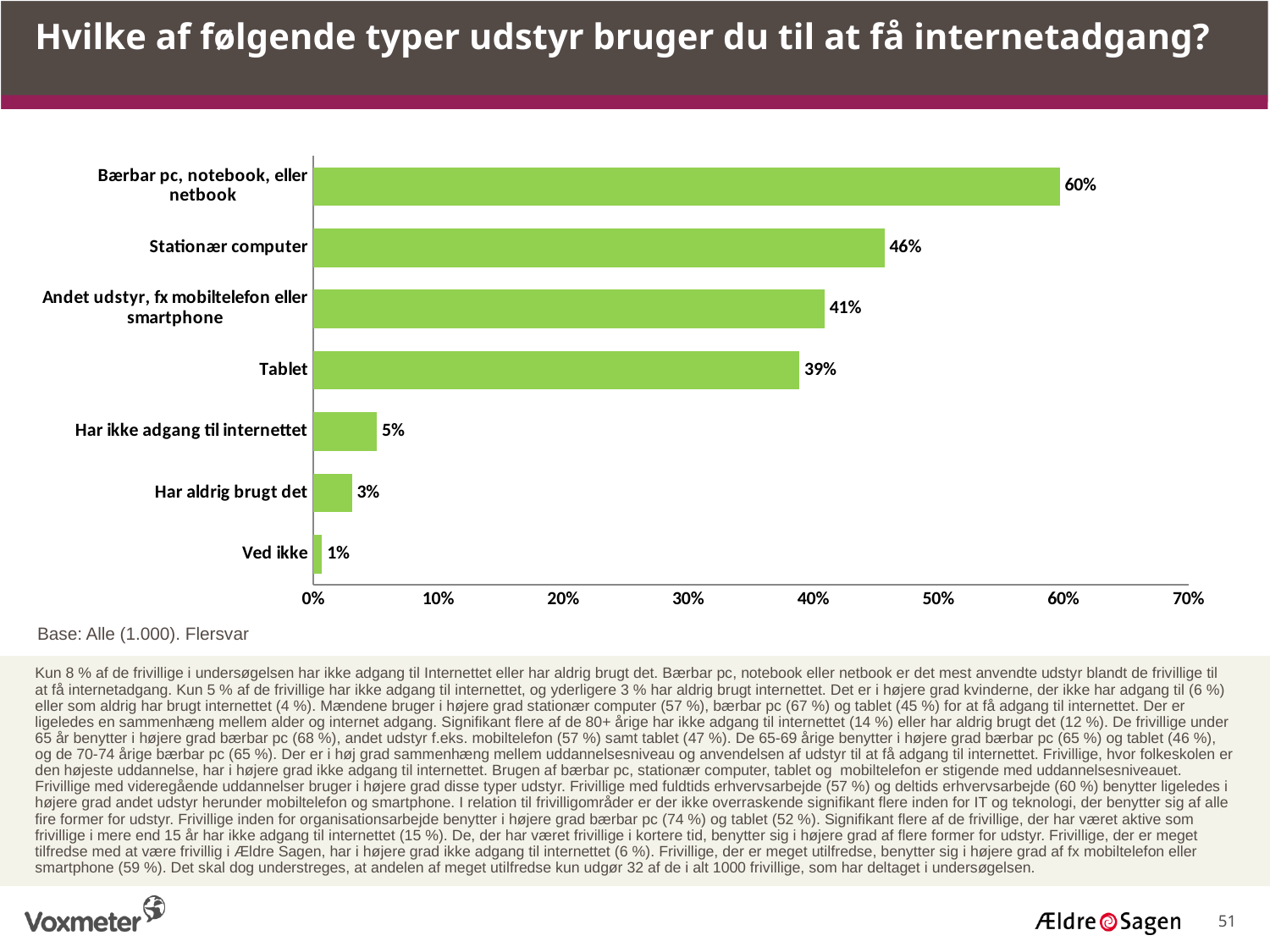
Which is larger, the value for "Har aldrig brugt det" or the value for "Har ikke adgang til internettet"? Har ikke adgang til internettet What is the value for "Stationær computer"? 46% What is the value for "Har ikke adgang til internettet"? 5% What is the difference between the values for "Bærbar pc, notebook, eller netbook" and "Stationær computer"? 14% What kind of chart is shown on the slide? bar chart What is the title of the chart? Hvilke af følgende typer udstyr bruger du til at få internetadgang? What is the difference between the values for "Andet udstyr, fx mobiltelefon eller smartphone" and "Tablet"? 2% What is the value for "Tablet"? 39% Which category has the lowest value? Ved ikke Which category has the highest value? Bærbar pc, notebook, eller netbook How many categories are shown in the chart? 7 Is the value for "Stationær computer" greater or less than 50%? less